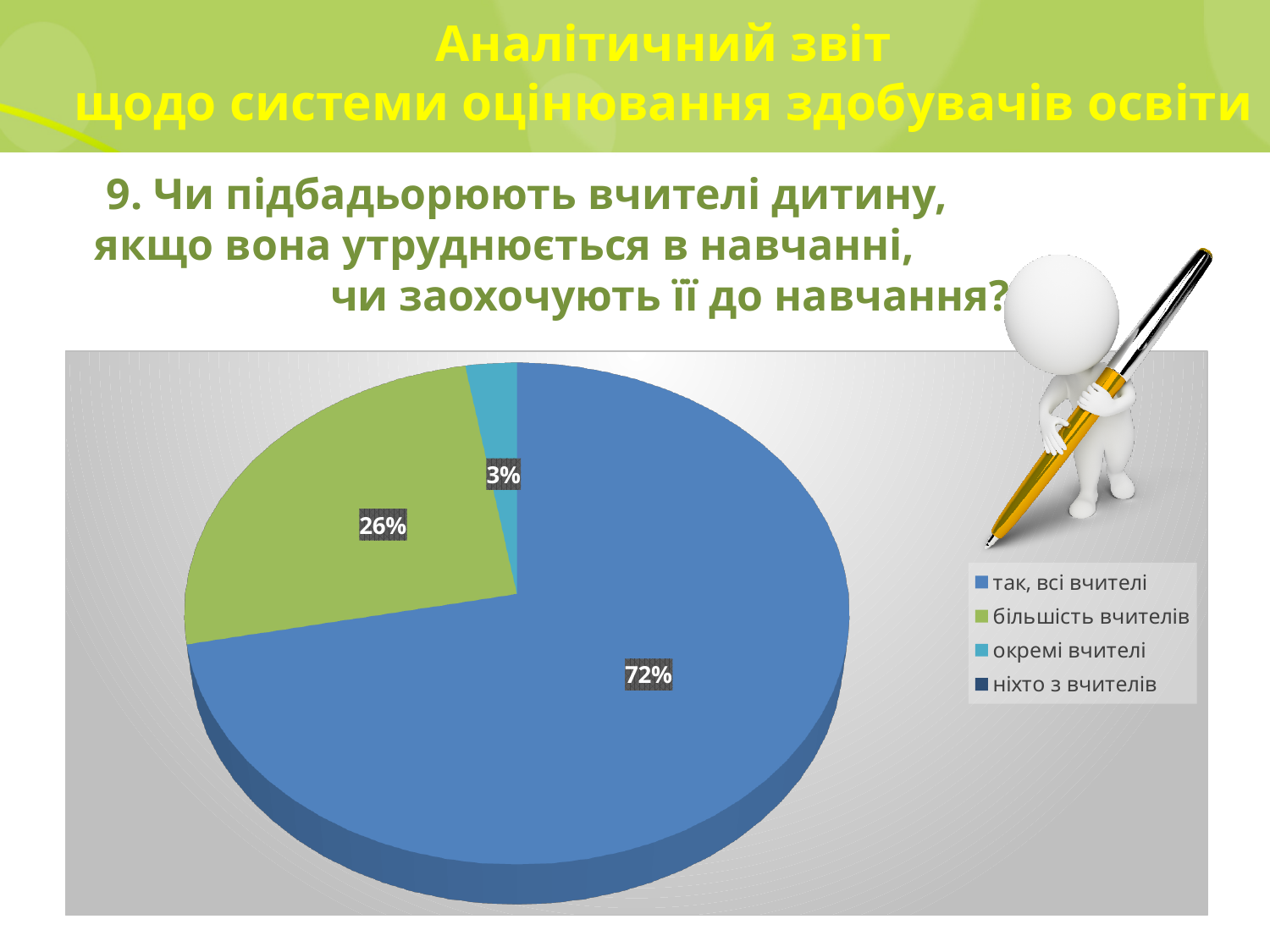
What percentage of the pie chart corresponds to "більшість вчителів"? 26% Which legend entry has no visible slice in the pie chart? ніхто з вчителів What is the difference in percentage points between the "так, всі вчителі" slice and the "більшість вчителів" slice? 46 percentage points What type of chart is shown on the slide? Pie chart What colour is the slice for "більшість вчителів"? Green What share of the pie does the blue slice represent? 72% Which category has the largest slice in the pie chart? так, всі вчителі Which slice is larger: "більшість вчителів" or "окремі вчителі"? більшість вчителів What percentage of the pie chart corresponds to "так, всі вчителі"? 72% Which of the labelled slices in the pie chart is the smallest? окремі вчителі How many entries does the legend of the chart list? 4 What percentage of the pie chart corresponds to "окремі вчителі"? 3%